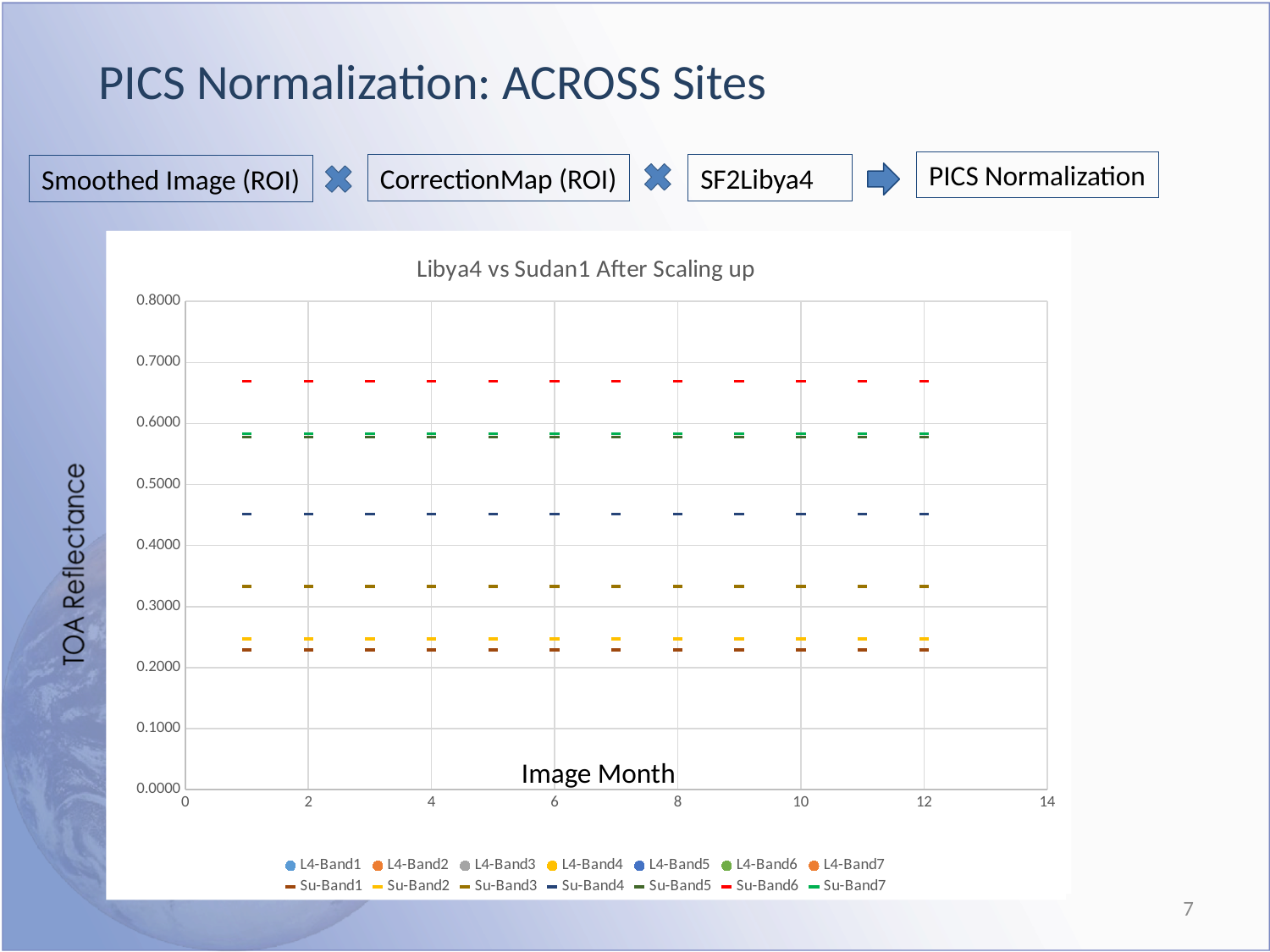
Is the value for Su-Band4 greater or less than 0.4000? greater How many image months have data points plotted in the chart? 12 What kind of chart is shown on the slide? scatter chart Do the plotted values rise, fall, or stay flat as the image month increases? stay flat How many series does the chart legend list? 14 Is the value for Su-Band4 greater or less than 0.5000? less Which series has the highest TOA Reflectance values in the chart? Su-Band6 Is the value for Su-Band3 greater or less than 0.3000? greater What is the title of the chart? Libya4 vs Sudan1 After Scaling up What is the label of the vertical axis? TOA Reflectance